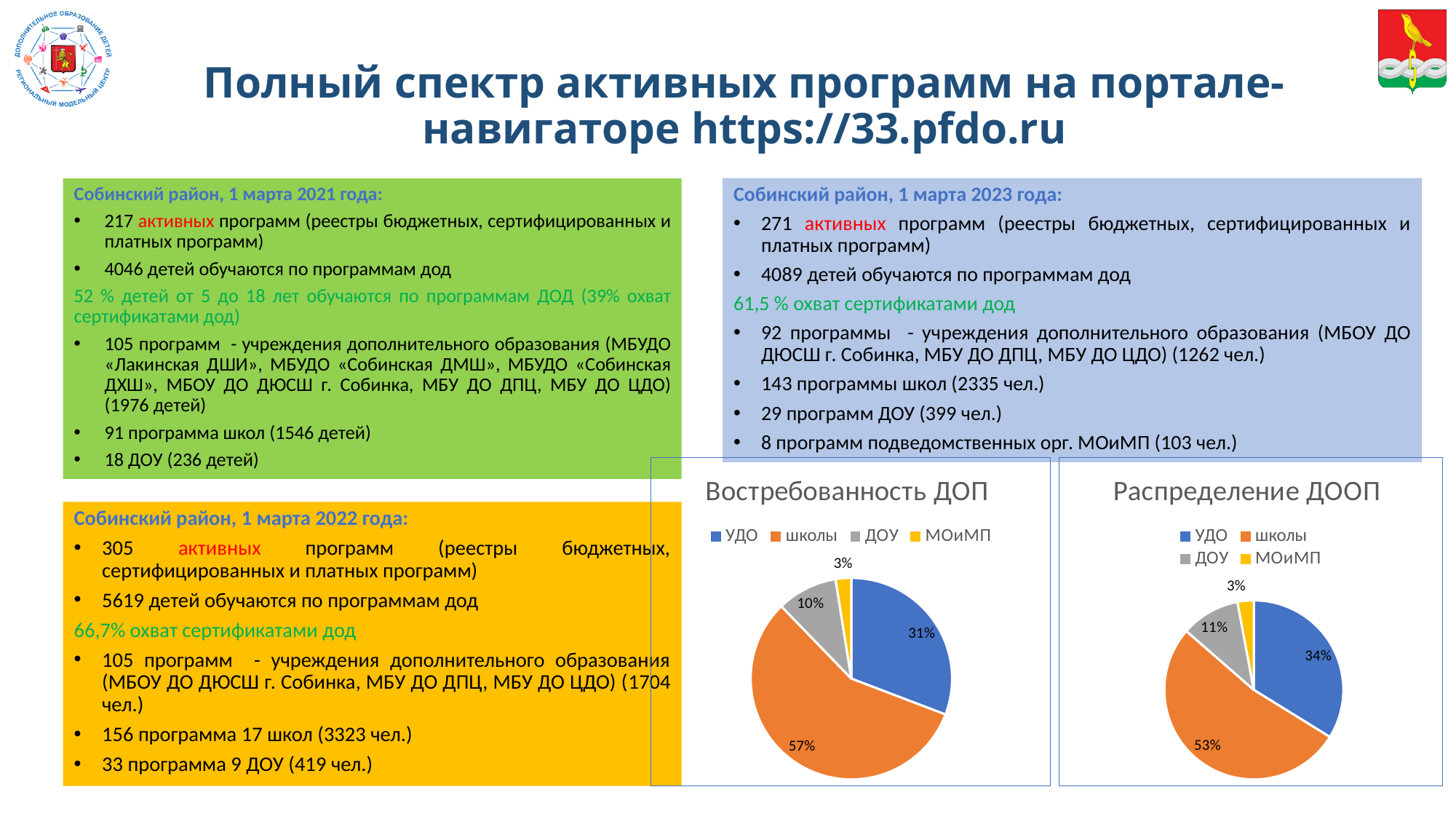
What colour represents "школы" in the chart titled "Востребованность ДОП"? orange In the chart titled "Распределение ДООП", which category has the smallest slice? МОиМП How many categories does the legend of the chart titled "Востребованность ДОП" list? 4 In the chart titled "Востребованность ДОП", which category has the largest slice? школы In the chart titled "Востребованность ДОП", what is the difference in percentage points between "школы" and "УДО"? 26 In the chart titled "Распределение ДООП", what share does "МОиМП" have? 3% In the chart titled "Востребованность ДОП", what share does "УДО" have? 31% In the chart titled "Распределение ДООП", what share does "школы" have? 53% In the chart titled "Распределение ДООП", which is larger: the share for "УДО" or the share for "ДОУ"? УДО In the chart titled "Востребованность ДОП", what share does "школы" have? 57% What type of chart is the chart titled "Распределение ДООП"? pie chart In the chart titled "Распределение ДООП", what share does "ДОУ" have? 11%